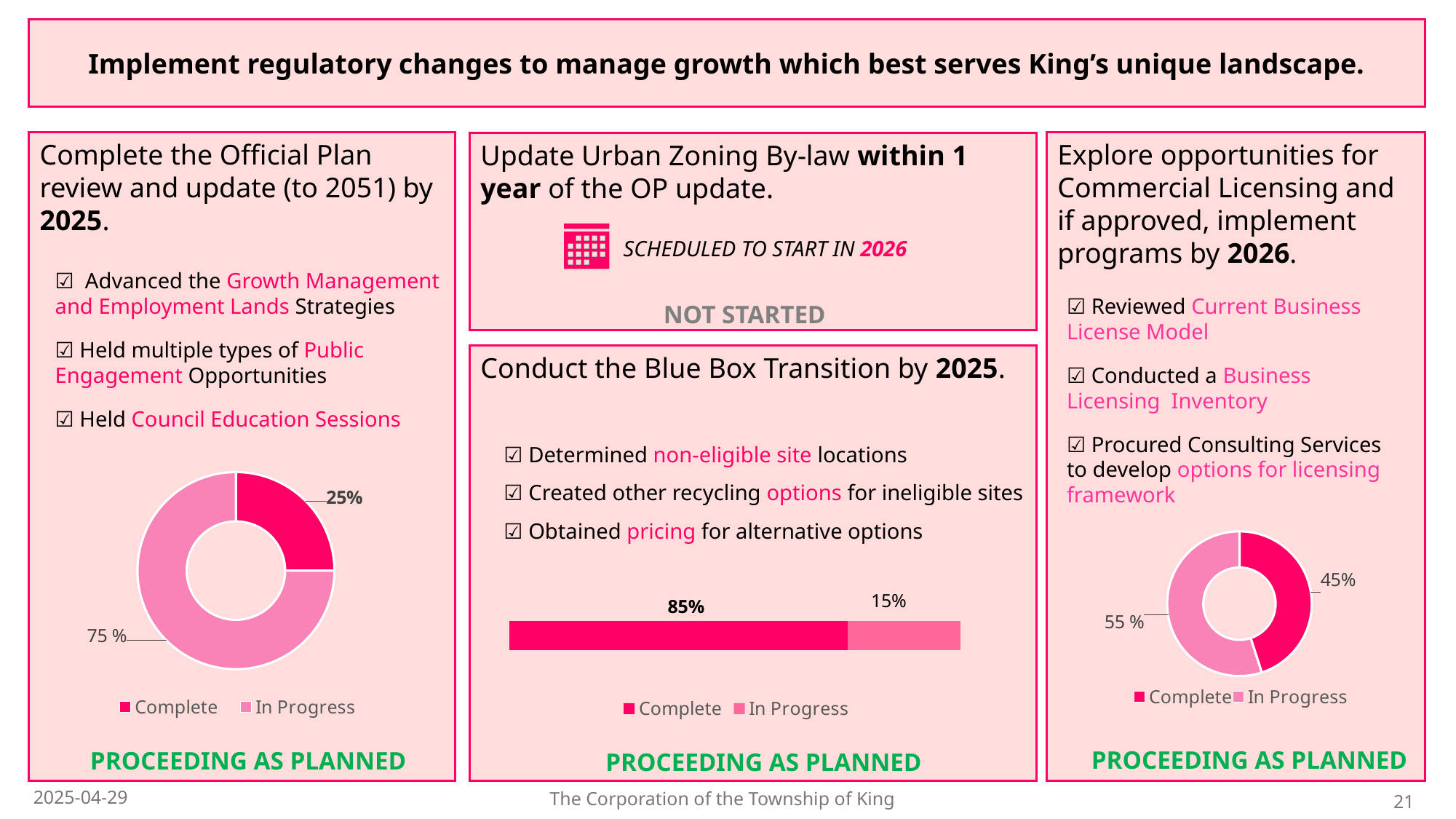
In the donut chart in the left panel (Official Plan review), which segment is larger, Complete or In Progress? In Progress In the donut chart in the right panel (Commercial Licensing), what share is labelled In Progress? 55 % In the donut chart in the left panel (Official Plan review), what share is labelled Complete? 25% In the donut chart in the right panel (Commercial Licensing), which segment is larger, Complete or In Progress? In Progress What kind of chart is shown in the middle panel (Blue Box Transition)? Bar chart In the bar chart in the middle panel (Blue Box Transition), what percentage is In Progress? 15% In the bar chart in the middle panel (Blue Box Transition), what is the difference between the Complete and In Progress percentages? 70% In the donut chart in the left panel (Official Plan review), what share is labelled In Progress? 75 % How many series does the legend list for the donut chart in the left panel (Official Plan review)? 2 In the donut chart in the right panel (Commercial Licensing), what share is labelled Complete? 45% Across the three charts on the slide, which panel's chart shows the highest Complete percentage? The middle panel (Blue Box Transition) In the bar chart in the middle panel (Blue Box Transition), what percentage is Complete? 85%